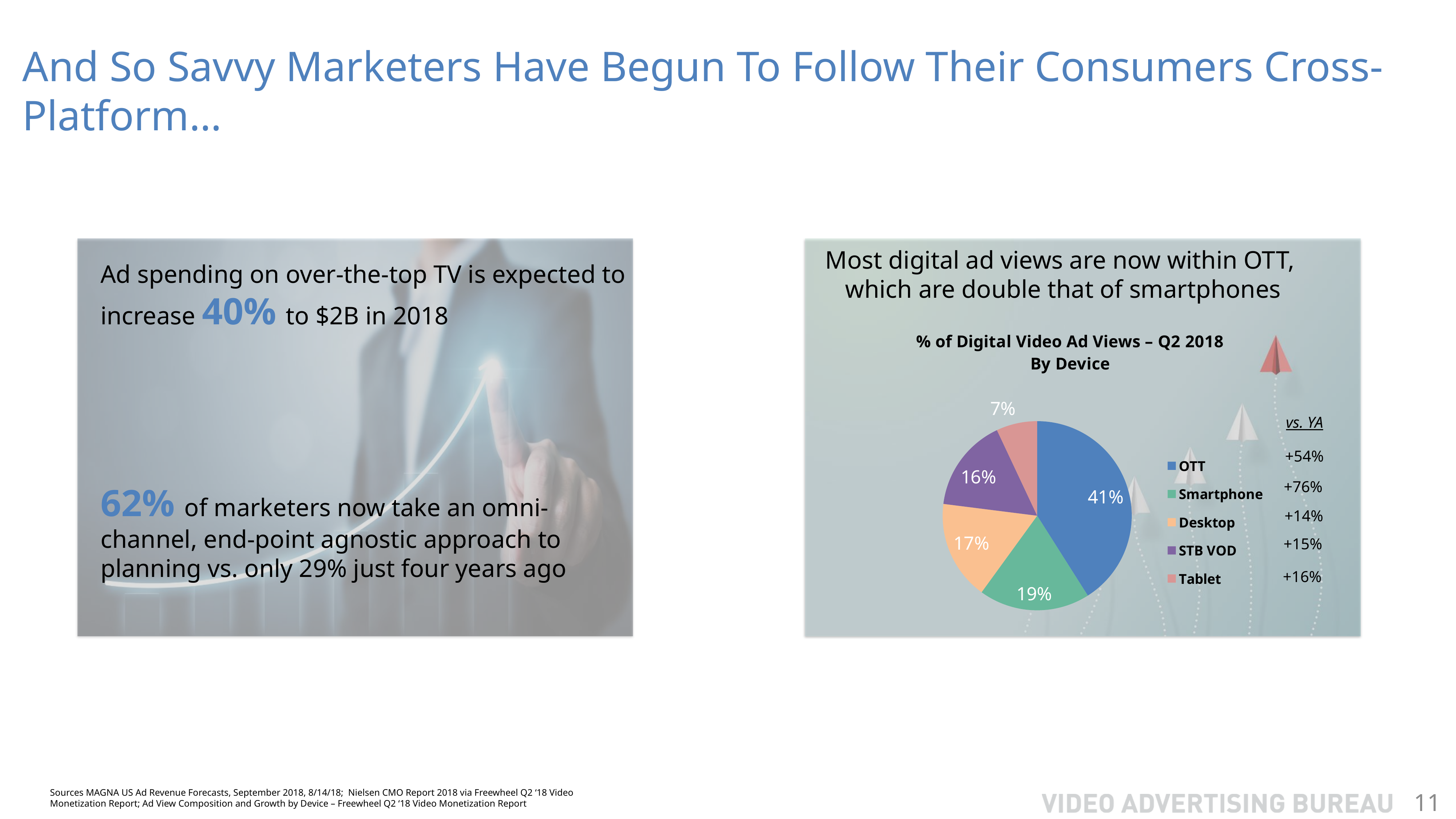
What percentage does the pie chart show for Desktop? 17% What type of chart is used to show the % of Digital Video Ad Views by device? Pie chart What is the title of the pie chart on the slide? % of Digital Video Ad Views – Q2 2018 By Device By how many percentage points does the OTT share exceed the Smartphone share in the pie chart? 22 percentage points Which device has the largest slice of the pie chart? OTT What is the value shown for Tablet in the pie chart? 7% What percentage of digital video ad views in Q2 2018 does the pie chart attribute to OTT? 41% Which device has the smallest slice of the pie chart? Tablet How many device categories are shown in the pie chart? 5 Which has a larger share in the pie chart, Desktop or STB VOD? Desktop What share of digital video ad views does the pie chart show for Smartphone? 19% What is the value for STB VOD in the pie chart? 16%